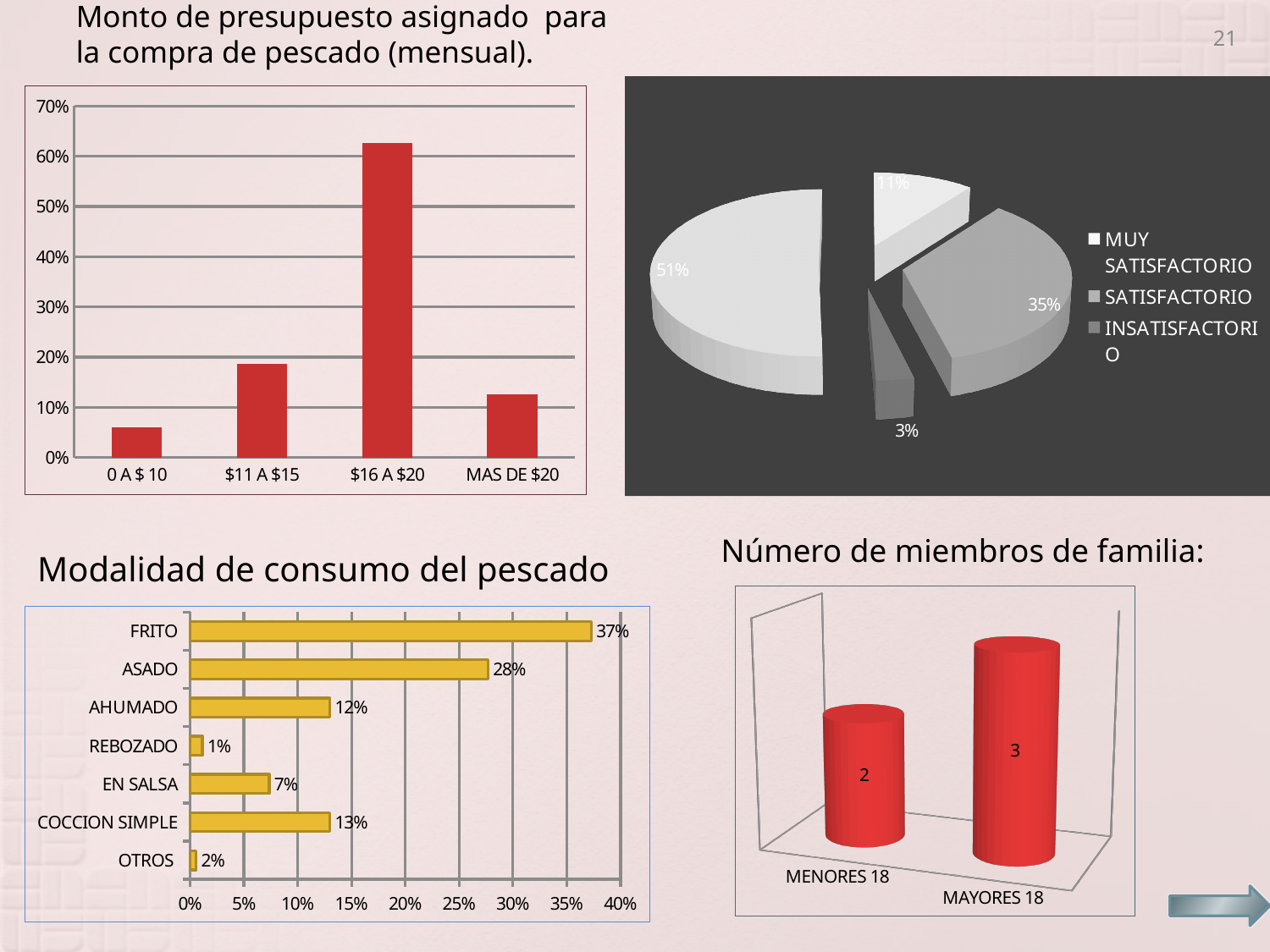
In the chart 'Monto de presupuesto asignado para la compra de pescado (mensual)', is the value for $11 A $15 greater or less than 10%? greater What kind of chart is the one in the top-right of the slide? Pie chart In the chart 'Modalidad de consumo del pescado', what is the value for FRITO? 37% In the chart 'Monto de presupuesto asignado para la compra de pescado (mensual)', which category has the highest value? $16 A $20 In the chart 'Modalidad de consumo del pescado', which category has the lowest value? REBOZADO In the chart 'Número de miembros de familia', what is the value for MAYORES 18? 3 In the pie chart in the top-right of the slide, what is the value of the largest slice? 51% How many entries does the legend of the pie chart in the top-right of the slide list? 3 In the chart 'Monto de presupuesto asignado para la compra de pescado (mensual)', which is larger, the value for 0 A $ 10 or the value for MAS DE $20? MAS DE $20 In the chart 'Modalidad de consumo del pescado', what is the value for COCCION SIMPLE? 13% In the chart 'Modalidad de consumo del pescado', what is the difference between the values for FRITO and ASADO? 9% How many categories are shown in the chart 'Modalidad de consumo del pescado'? 7